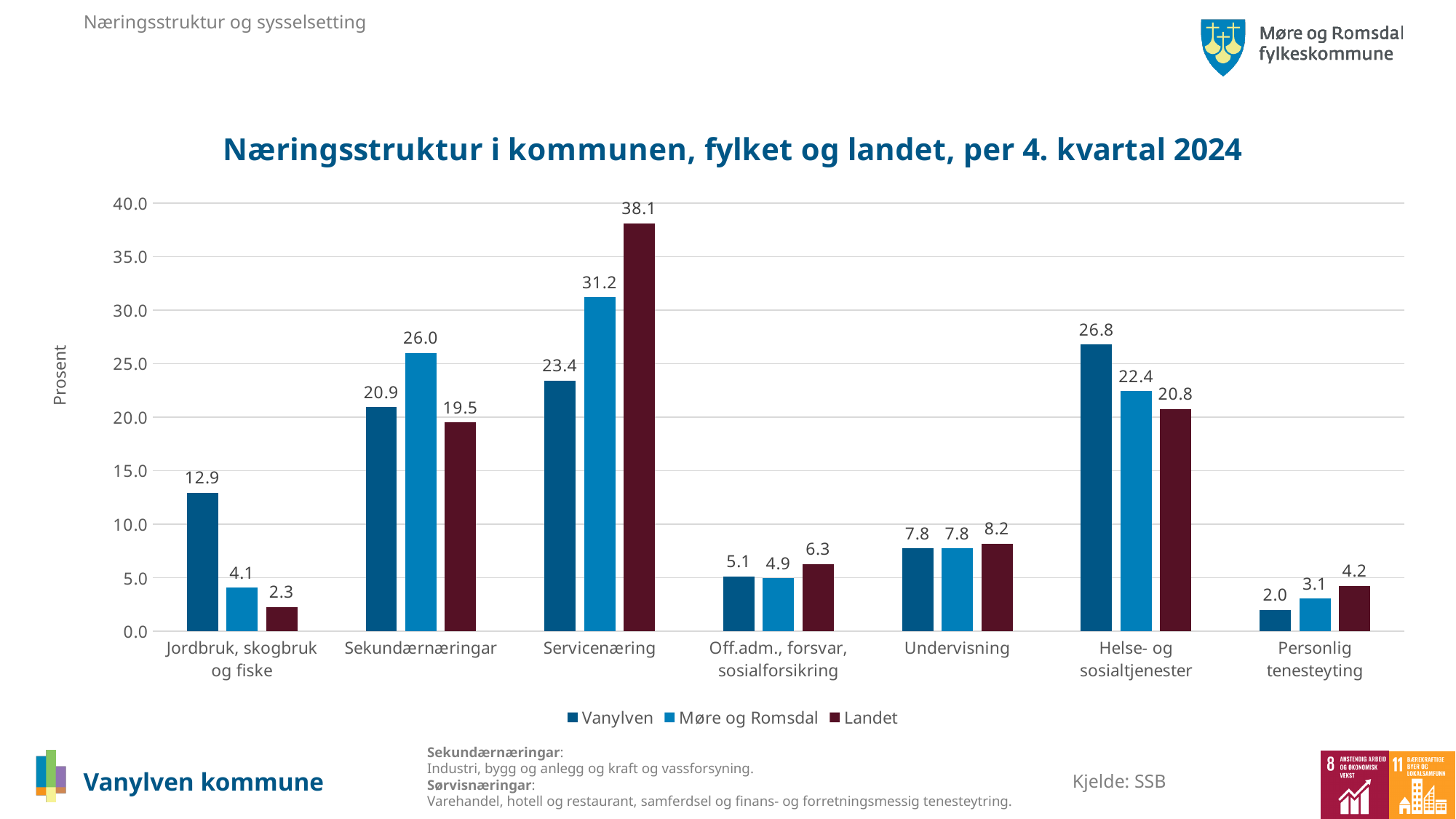
How many categories are shown on the x axis? 7 How many series does the legend list? 3 What is the value for Landet in the Servicenæring category? 38.1 What is the value for Møre og Romsdal in the Helse- og sosialtjenester category? 22.4 What kind of chart is shown on the slide? Bar chart Which category has the highest value for Landet? Servicenæring What is the title of the chart? Næringsstruktur i kommunen, fylket og landet, per 4. kvartal 2024 What is the difference between the Landet and Vanylven values in the Servicenæring category? 14.7 Which category has the lowest value for Vanylven? Personlig tenesteyting Which is larger in the Sekundærnæringar category: Vanylven or Møre og Romsdal? Møre og Romsdal What is the label on the y axis? Prosent What is the value for Vanylven in the Jordbruk, skogbruk og fiske category? 12.9